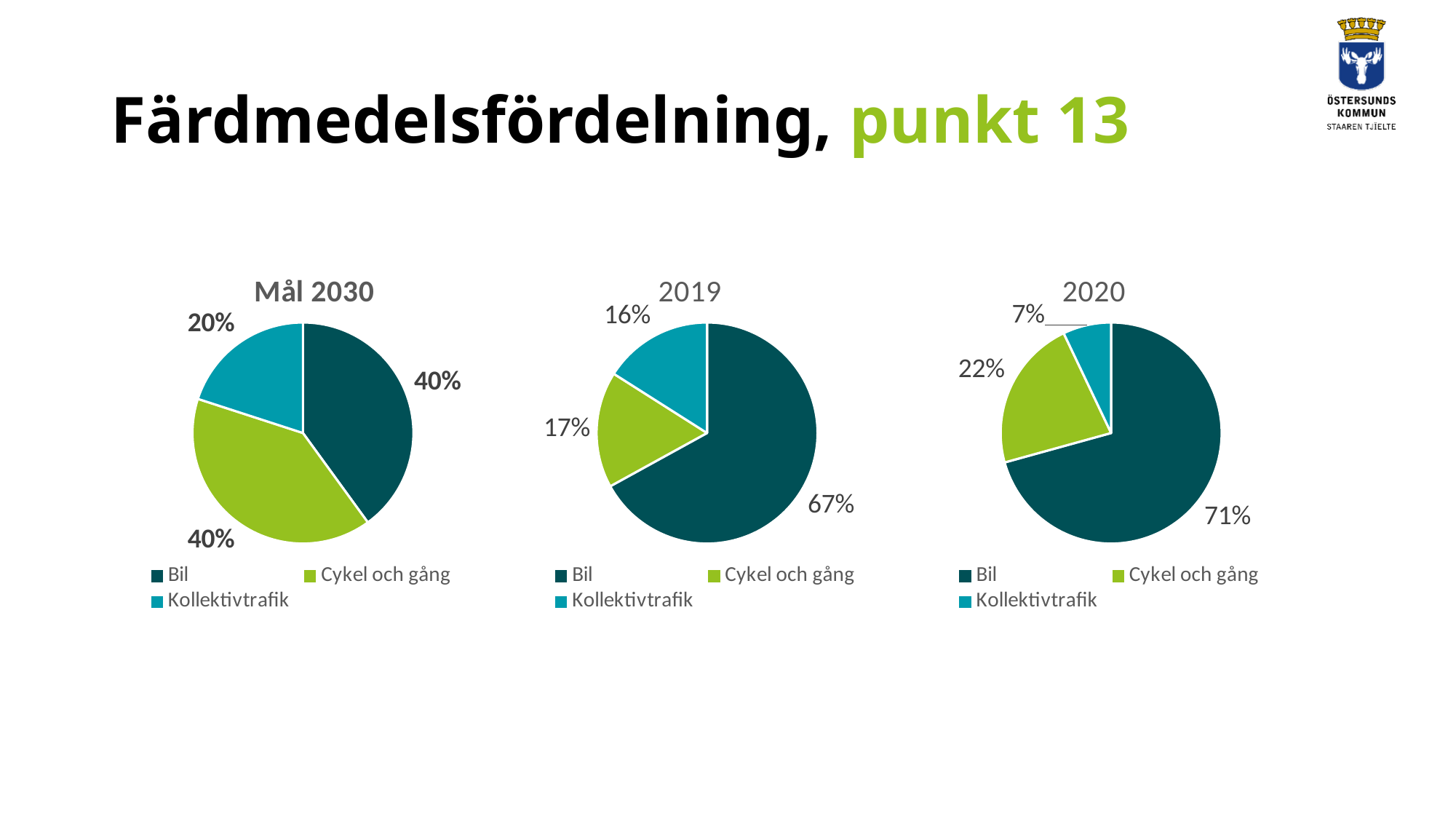
In the '2019' pie chart, what share does Bil have? 67% In the '2020' pie chart, what share does Kollektivtrafik have? 7% In the '2020' pie chart, which category has the largest share? Bil In the 'Mål 2030' pie chart, what share does Kollektivtrafik have? 20% In the '2019' pie chart, which category has the smallest share? Kollektivtrafik How many slices does the 'Mål 2030' pie chart have? 3 Which is larger: the share of Bil in the '2019' chart or in the '2020' chart? 2020 How many entries does the legend of the '2020' chart list? 3 In the '2020' pie chart, what share does Cykel och gång have? 22% In the '2020' pie chart, what is the difference between the shares of Cykel och gång and Kollektivtrafik? 15% In the '2019' pie chart, what is the difference between the shares of Bil and Cykel och gång? 50% What type of chart is the '2019' chart? Pie chart